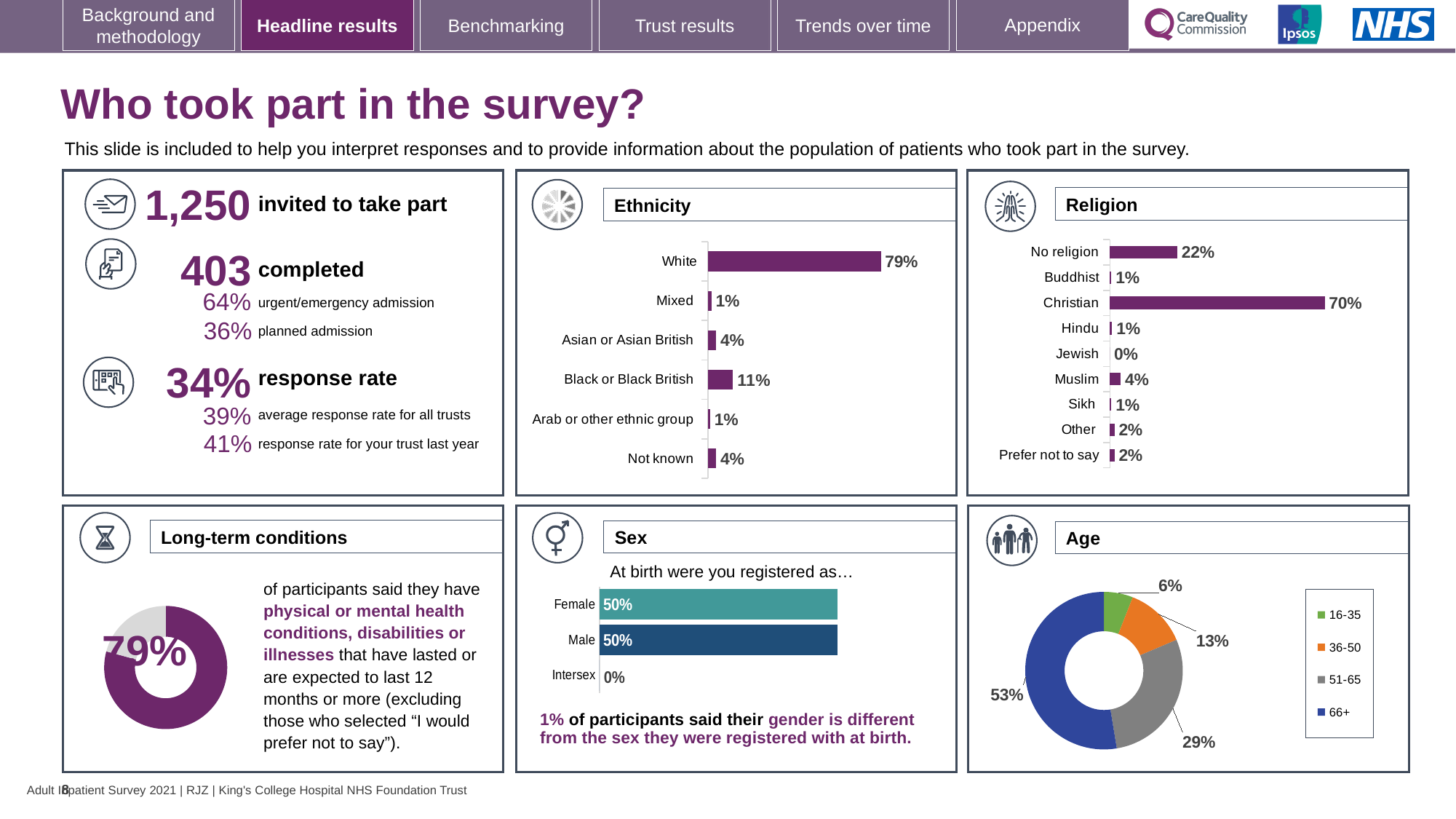
In the Religion chart, which religion category has the highest percentage? Christian In the Ethnicity chart, which ethnic group has the lowest percentage among Mixed, Asian or Asian British and Black or Black British? Mixed In the Sex chart, what percentage of participants were registered as Female at birth? 50% In the Age chart, what share of participants were aged 66+? 53% In the Ethnicity chart, what is the difference between the percentages for Black or Black British and Asian or Asian British? 7% How many age groups does the legend of the Age chart list? 4 How many categories are shown in the Religion chart? 9 What kind of chart is used for the Age breakdown? Donut chart In the Religion chart, what percentage of participants were Christian? 70% How many ethnic group categories are shown in the Ethnicity chart? 6 In the Religion chart, which is larger, the percentage for No religion or the percentage for Muslim? No religion In the Ethnicity chart, what percentage of participants were White? 79%